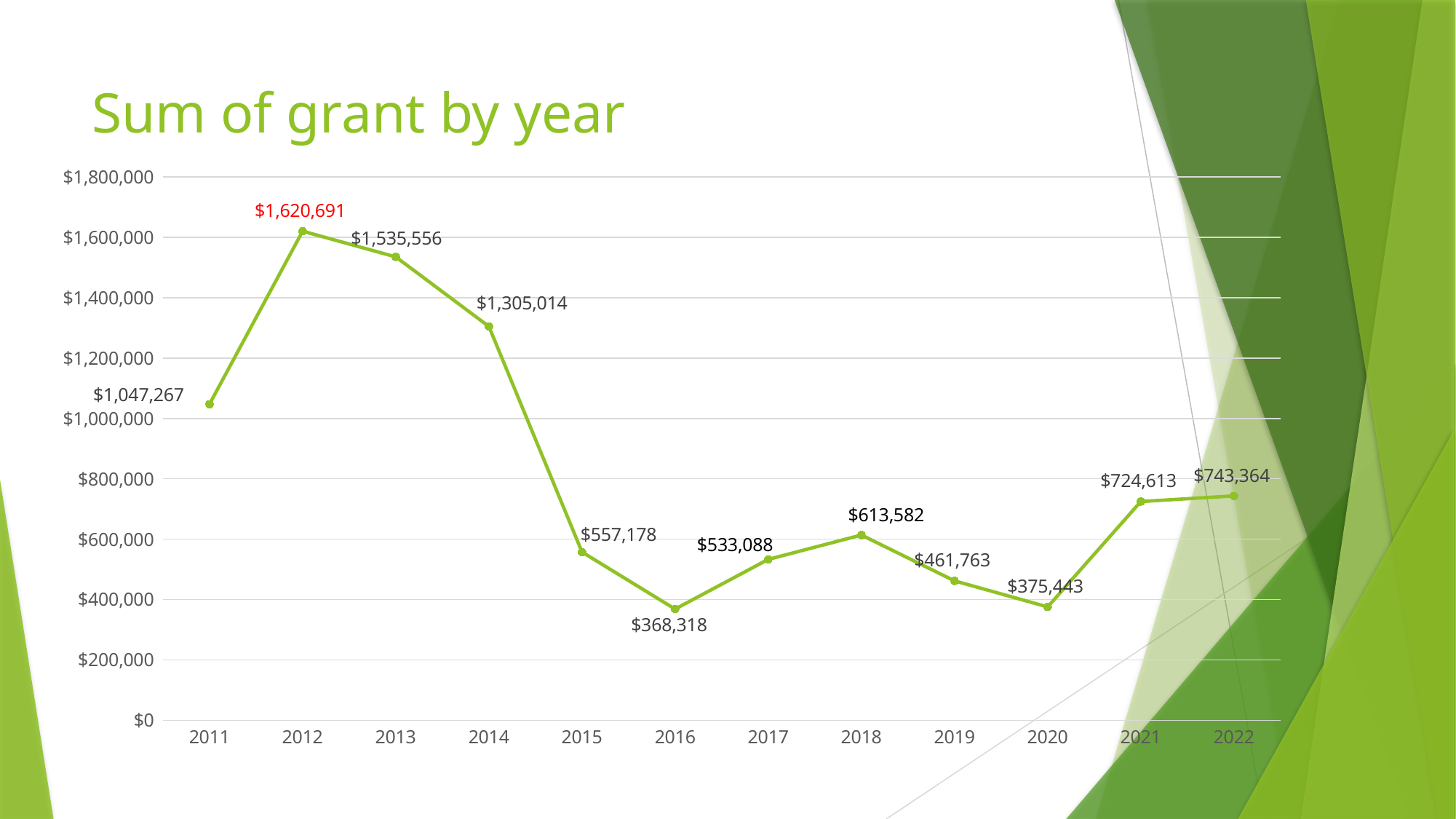
What is the sum of grant for 2014? $1,305,014 What is the sum of grant for 2022? $743,364 Which year has a larger sum of grant, 2018 or 2019? 2018 What is the difference between the sum of grant in 2012 and in 2011? $573,424 How many years are plotted on the chart? 12 Which year has the highest sum of grant? 2012 What is the difference between the sum of grant in 2014 and in 2015? $747,836 What kind of chart is shown on the slide? line chart What is the sum of grant for 2020? $375,443 Does the sum of grant rise or fall from 2012 to 2016? fall Is the sum of grant for 2013 greater or less than $1,400,000? greater Which year has the lowest sum of grant? 2016